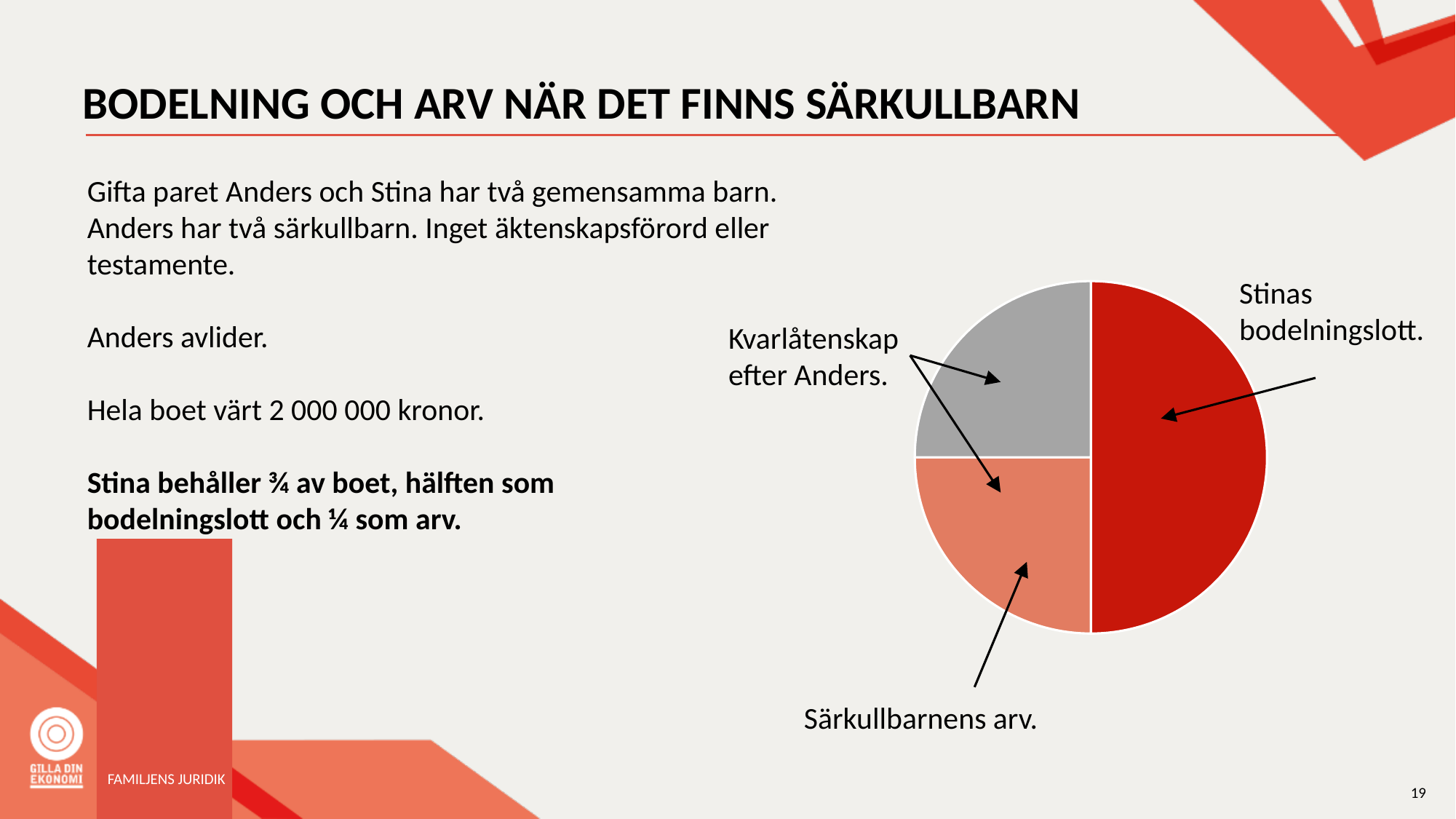
How many slices does the pie chart have? 3 What colour is the slice labelled Stinas bodelningslott? red Does the slice for Stinas bodelningslott take up more or less than a quarter of the pie? more Which is larger in the pie chart: Stinas bodelningslott or Särkullbarnens arv? Stinas bodelningslott Which slice of the pie chart is the largest? Stinas bodelningslott What colour is the slice labelled Särkullbarnens arv? salmon/light red Does the slice for Särkullbarnens arv take up more or less than half of the pie? less What kind of chart is shown on the slide? pie chart